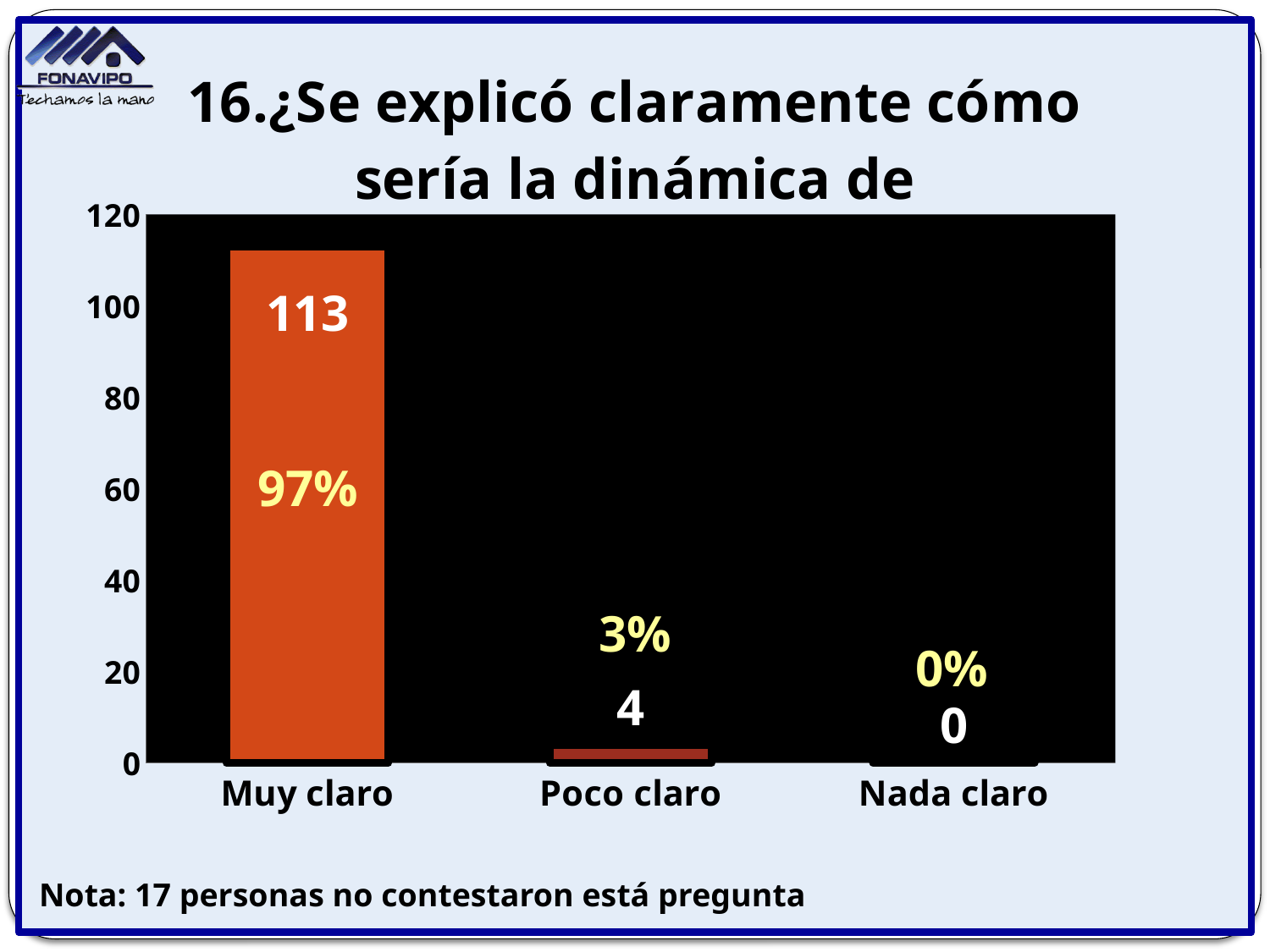
What percentage is shown for Muy claro? 97% What is the count for Nada claro? 0 What is the difference between the counts for Muy claro and Poco claro? 109 Is the value for Muy claro greater or less than 100? greater Which is larger, the count for Poco claro or the count for Nada claro? Poco claro How many categories are shown on the x axis? 3 Which category has the lowest count? Nada claro Which category has the highest count? Muy claro What is the count for Poco claro? 4 What kind of chart is shown on the slide? bar chart What percentage is shown for Poco claro? 3% What is the count for Muy claro? 113